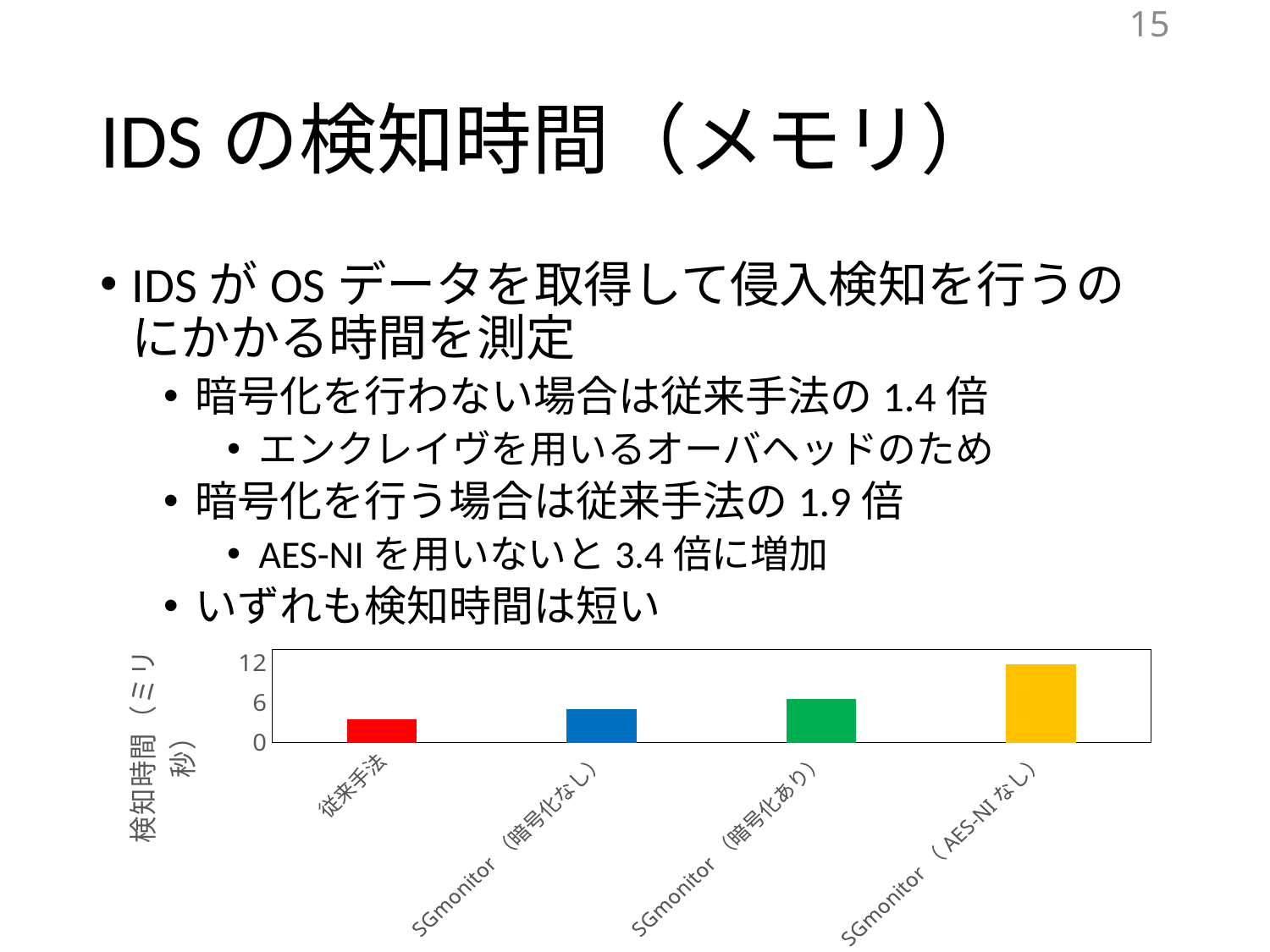
Which is larger, the value for 従来手法 or the value for SGmonitor（AES-NI なし）? SGmonitor（AES-NI なし） Is the value for SGmonitor（暗号化なし） greater or less than 6? less What colour is the bar for SGmonitor（AES-NI なし）? yellow How many categories are plotted in the chart? 4 What is the label of the vertical axis of the chart? 検知時間（ミリ秒） Which category has the highest detection time in the chart? SGmonitor（AES-NI なし） What kind of chart is shown on the slide? bar chart Is the value for 従来手法 greater or less than 6? less Which is larger, the value for SGmonitor（暗号化なし） or the value for SGmonitor（暗号化あり）? SGmonitor（暗号化あり） Which category has the lowest detection time in the chart? 従来手法 Do the values rise or fall from left to right along the x axis? rise Is the value for SGmonitor（AES-NI なし） greater or less than 6? greater